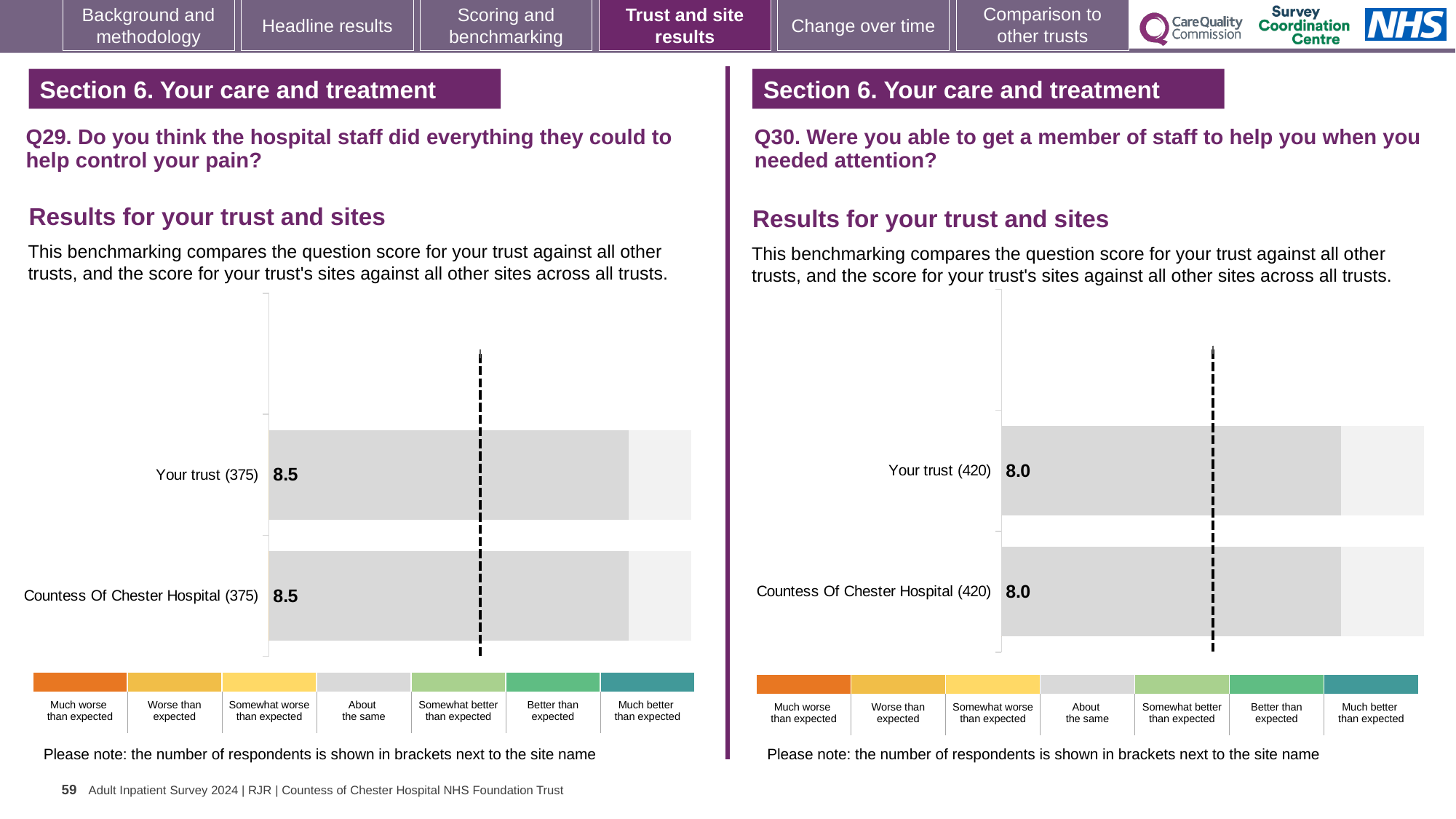
On the Q30 chart (right), what is the score for Your trust? 8.0 How many bars are plotted on the Q29 chart (left)? 2 Is the Your trust score on the Q29 chart (left) larger or smaller than the Your trust score on the Q30 chart (right)? Larger On the Q30 chart (right), what is the difference between the Your trust score and the Countess Of Chester Hospital score? 0.0 On the Q29 chart (left), what is the difference between the Your trust score and the Countess Of Chester Hospital score? 0.0 What kind of chart is used on the Q29 chart (left)? Bar chart On the Q29 chart (left), what is the score for Your trust? 8.5 On the Q30 chart (right), what is the score for Countess Of Chester Hospital? 8.0 On the Q29 chart (left), how many respondents are shown in brackets for Your trust? 375 On the Q29 chart (left), what is the score for Countess Of Chester Hospital? 8.5 On the Q30 chart (right), how many respondents are shown in brackets for Countess Of Chester Hospital? 420 How many bars are plotted on the Q30 chart (right)? 2